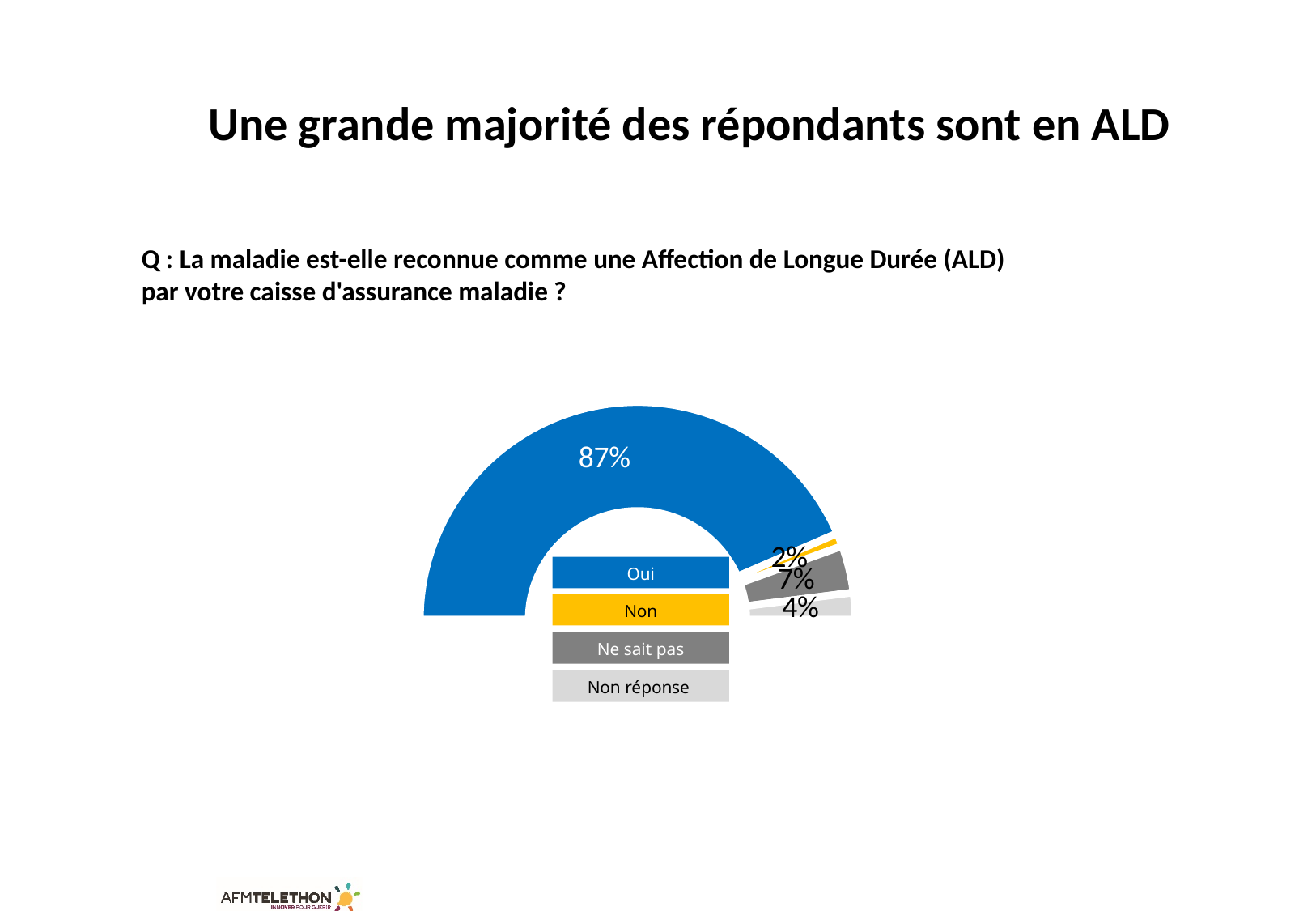
Which is larger, the share for "Ne sait pas" or the share for "Non réponse"? Ne sait pas Which response category has the largest share? Oui What percentage of respondents answered "Non réponse"? 4% What colour is the "Non" segment in the chart? Yellow What percentage of respondents answered "Ne sait pas"? 7% Which response category has the smallest share? Non What is the difference in percentage points between "Ne sait pas" and "Non réponse"? 3 What is the difference in percentage points between "Oui" and "Ne sait pas"? 80 What percentage of respondents answered "Oui"? 87% What percentage of respondents answered "Non"? 2% What kind of chart is shown on the slide? Donut (pie) chart How many response categories does the chart show? 4